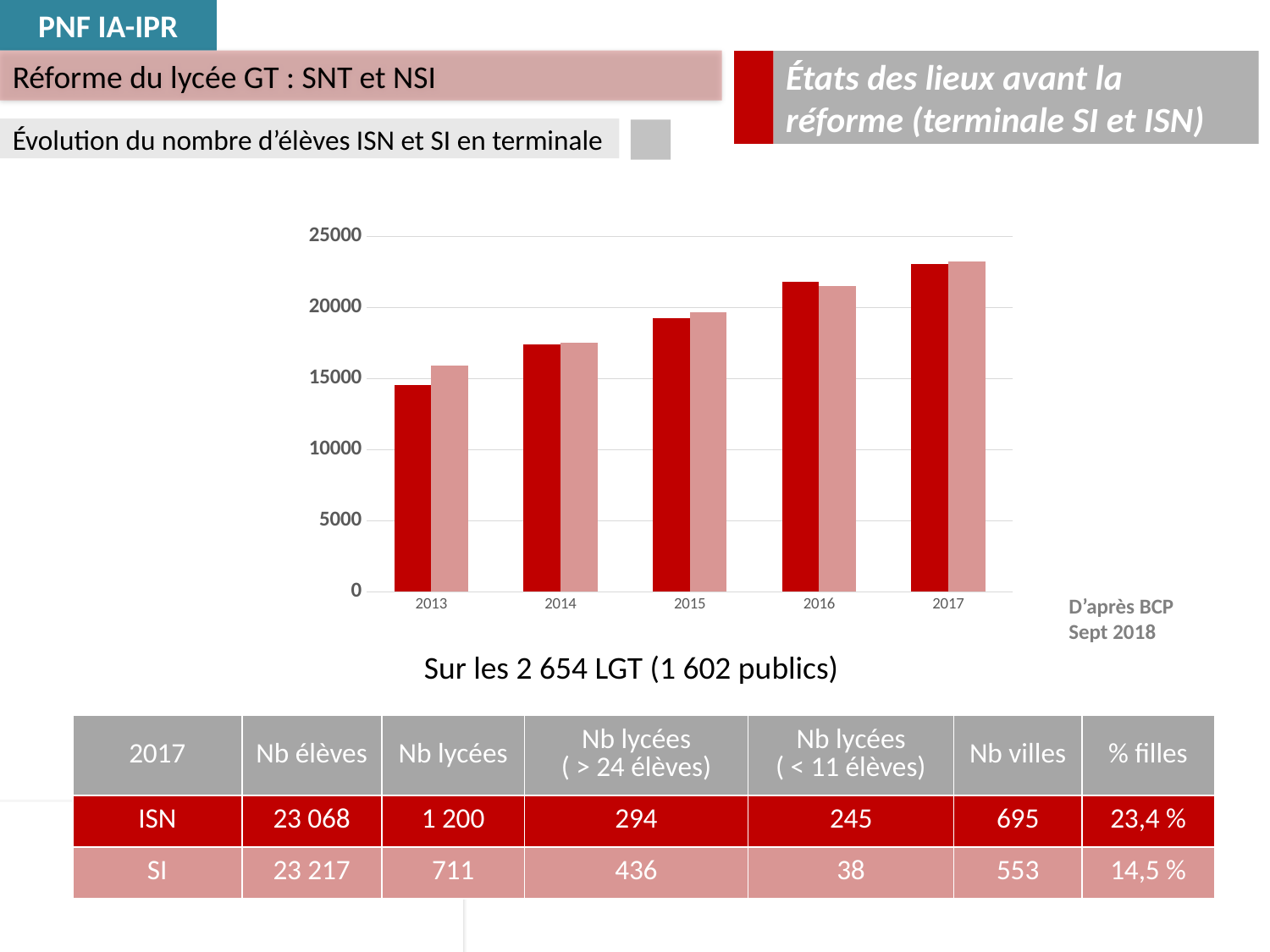
Which year has the tallest dark red bar? 2017 How many years are shown on the x axis of the chart? 5 Is the value of the light pink bar for 2013 greater or less than 15000? greater Do the dark red bars rise or fall from 2013 to 2017? rise Is the value of the dark red bar for 2013 greater or less than 15000? less In 2013, which bar is taller, the dark red bar or the light pink bar? the light pink bar What kind of chart is shown on the slide? bar chart How many bars are shown for each year in the chart? 2 Is the value of the dark red bar for 2017 greater or less than 20000? greater Which year has the shortest light pink bar? 2013 What is the highest value shown on the y axis of the chart? 25000